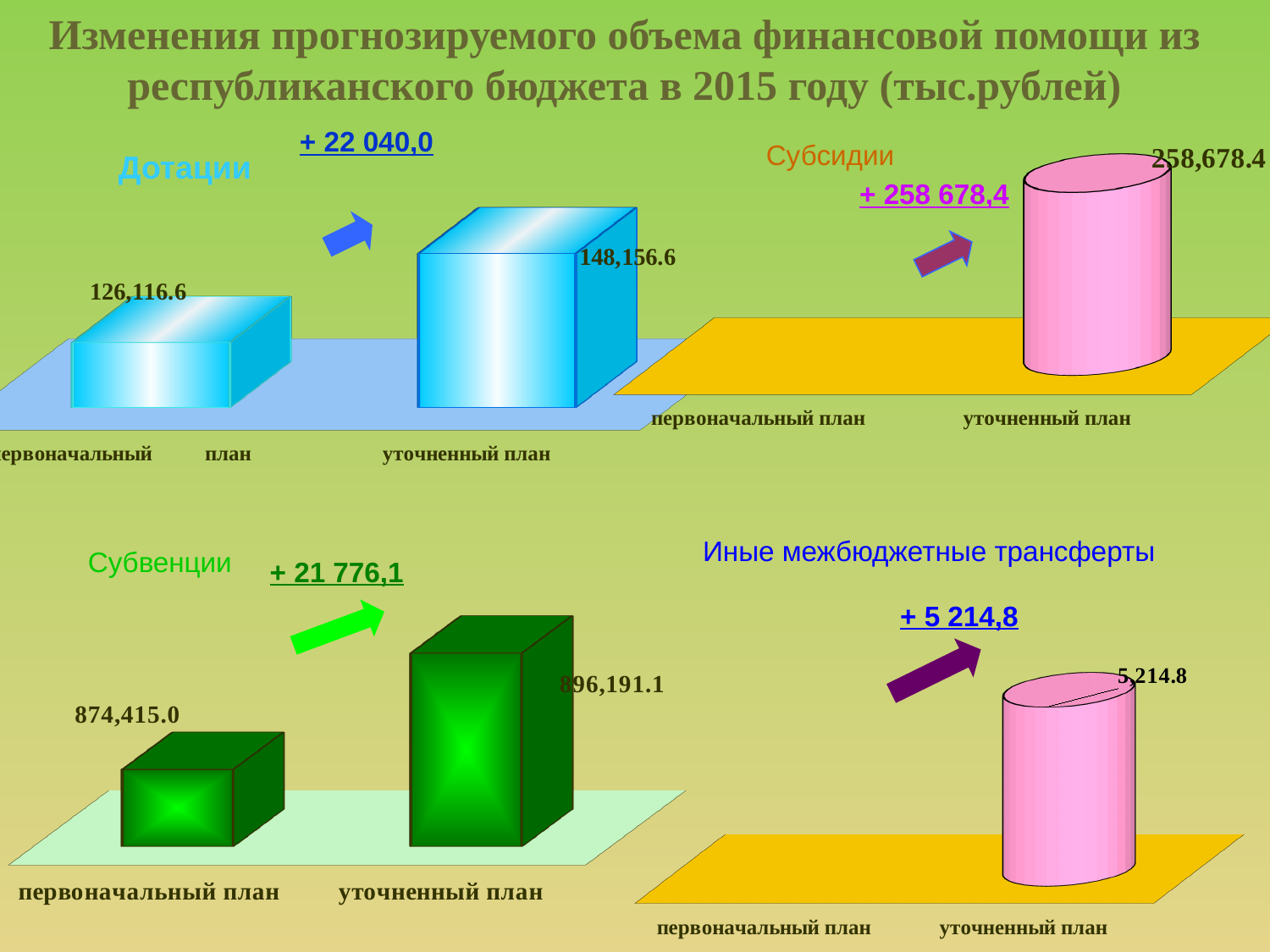
In the Дотации chart, what is the value for первоначальный план? 126,116.6 What kind of chart is the Дотации chart? bar chart In the Дотации chart, what is the value for уточненный план? 148,156.6 In the Субвенции chart, what is the value for уточненный план? 896,191.1 In the Дотации chart, what is the difference between уточненный план and первоначальный план? 22,040.0 In the Субвенции chart, which is larger, первоначальный план or уточненный план? уточненный план In the Субвенции chart, what is the difference between уточненный план and первоначальный план? 21,776.1 How many charts are shown on the slide? 4 In the Субсидии chart, what is the value for уточненный план? 258,678.4 In the Субвенции chart, what is the value for первоначальный план? 874,415.0 In the Иные межбюджетные трансферты chart, what is the value for уточненный план? 5,214.8 In the Дотации chart, do the values rise or fall from первоначальный план to уточненный план? rise